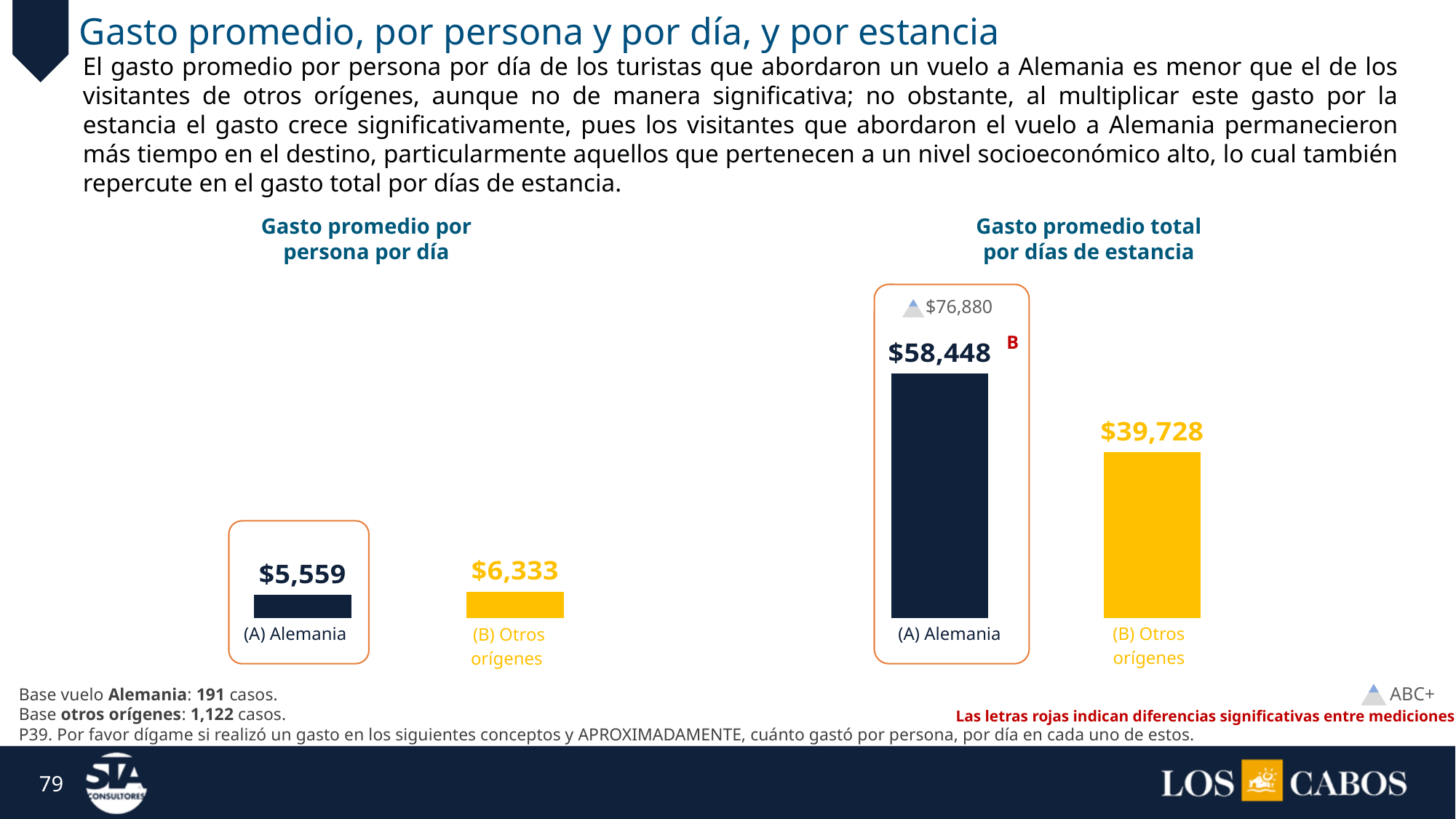
In the 'Gasto promedio total por días de estancia' chart, what value is shown next to the ABC+ triangle marker above the (A) Alemania bar? $76,880 In the 'Gasto promedio total por días de estancia' chart, what is the value for (B) Otros orígenes? $39,728 In the 'Gasto promedio total por días de estancia' chart, what is the value for (A) Alemania? $58,448 In the 'Gasto promedio por persona por día' chart, what is the difference between (B) Otros orígenes and (A) Alemania? $774 In the 'Gasto promedio por persona por día' chart, what is the value for (A) Alemania? $5,559 In the 'Gasto promedio total por días de estancia' chart, what is the difference between (A) Alemania and (B) Otros orígenes? $18,720 In the 'Gasto promedio total por días de estancia' chart, which category has the lower value? (B) Otros orígenes In the 'Gasto promedio por persona por día' chart, what is the value for (B) Otros orígenes? $6,333 How many categories are shown in the 'Gasto promedio por persona por día' chart? 2 What kind of chart is the 'Gasto promedio total por días de estancia' chart? bar chart In the 'Gasto promedio por persona por día' chart, which category has the higher value? (B) Otros orígenes In the 'Gasto promedio total por días de estancia' chart, is the value for (A) Alemania larger or smaller than the value for (B) Otros orígenes? larger